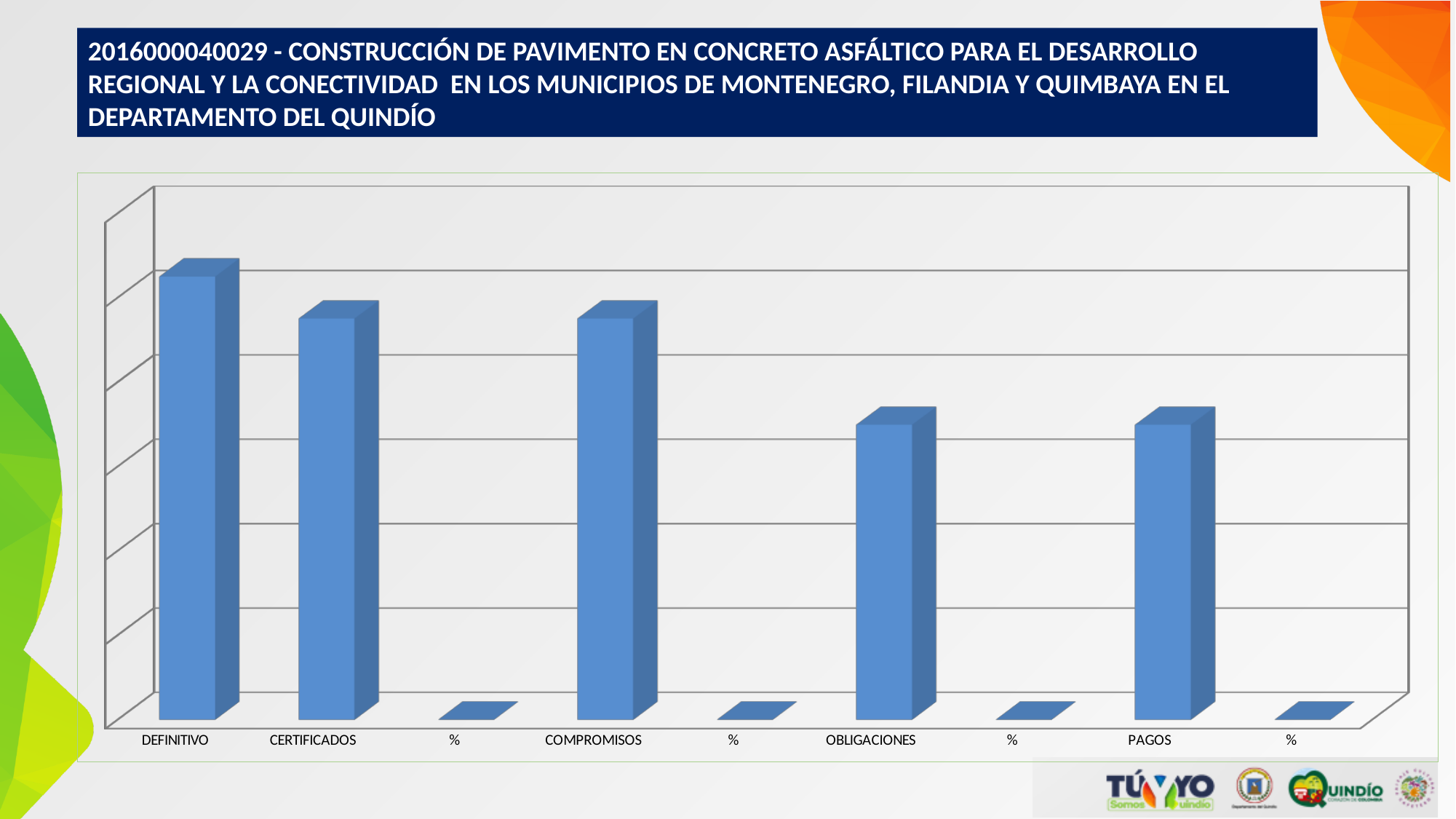
Which bar is taller, CERTIFICADOS or PAGOS? CERTIFICADOS How many categories are shown along the x axis of the chart? 9 What kind of chart is shown on the slide? bar chart Which bar is taller, DEFINITIVO or COMPROMISOS? DEFINITIVO What colour are the bars in the chart? blue Which bar is taller, COMPROMISOS or OBLIGACIONES? COMPROMISOS What is the label of the first category on the x axis? DEFINITIVO Which category has the tallest bar in the chart? DEFINITIVO